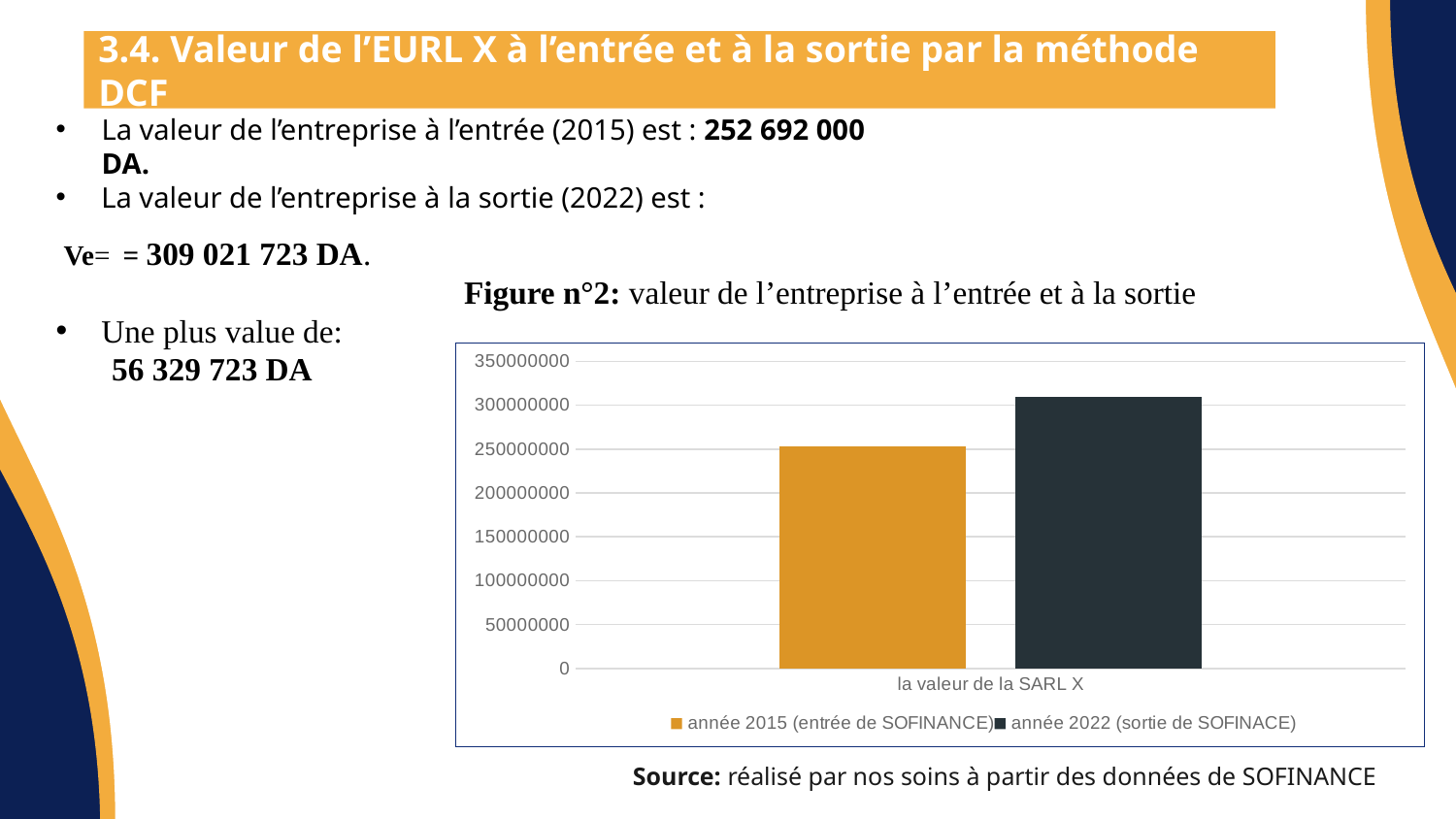
Which series has the highest value in the chart? année 2022 (sortie de SOFINACE) How many categories are shown on the x axis of the chart? 1 Is the value for année 2022 (sortie de SOFINACE) greater or less than 300000000? greater Is the value for année 2015 (entrée de SOFINANCE) greater or less than 300000000? less What kind of chart is shown in Figure n°2? bar chart What is the category label shown on the x axis of the chart? la valeur de la SARL X Is the value for année 2015 (entrée de SOFINANCE) greater or less than 200000000? greater Which series has the taller bar, année 2015 (entrée de SOFINANCE) or année 2022 (sortie de SOFINACE)? année 2022 (sortie de SOFINACE) Which series has the lowest value in the chart? année 2015 (entrée de SOFINANCE) How many series does the legend of the chart list? 2 What colour is the bar for année 2015 (entrée de SOFINANCE)? orange